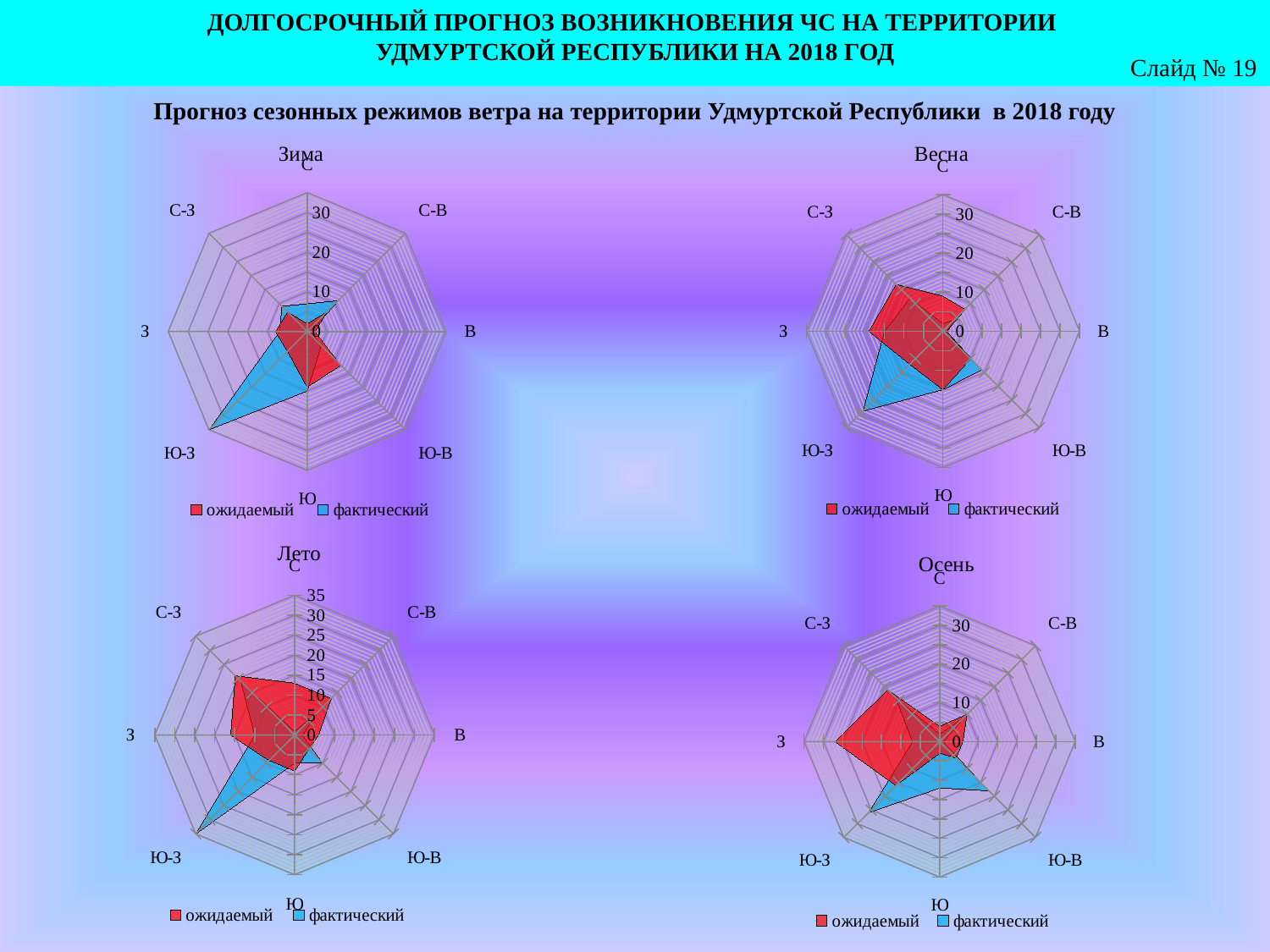
On the "Весна" chart, which direction has the highest фактический value? Ю-З How many series does the legend of the "Осень" chart list? 2 What kind of chart is the "Зима" chart? radar chart What are the two series named in the legend of the "Весна" chart? ожидаемый, фактический How many wind directions (categories) are plotted on the "Лето" chart? 8 On the "Осень" chart, which direction has the highest ожидаемый value? З What are the titles of the four charts on the slide? Зима, Весна, Лето, Осень On the "Лето" chart, is the фактический value for Ю-З greater or less than 25? greater On the "Осень" chart, is the ожидаемый value for З greater or less than 10? greater On the "Зима" chart, which direction has the highest фактический value? Ю-З On the "Зима" chart, is the фактический value for Ю-З greater or less than 20? greater